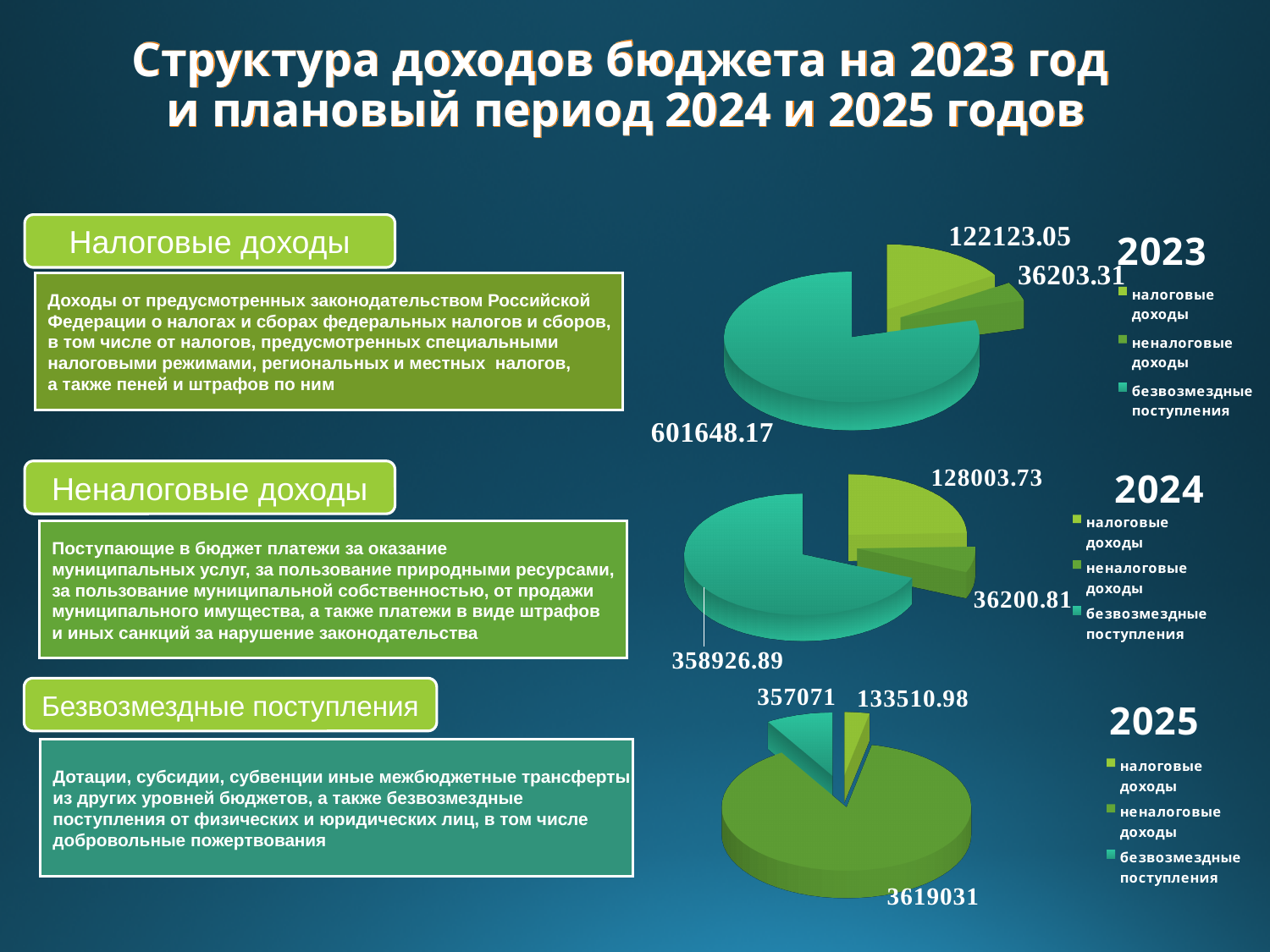
In the 2023 chart, what is the value for неналоговые доходы? 36203.31 In the 2023 chart, what is the value of the largest slice (безвозмездные поступления)? 601648.17 In the 2024 chart, what is the value for налоговые доходы? 128003.73 How many entries does the legend of the 2023 chart list? 3 In the 2024 chart, which slice is the smallest? неналоговые доходы (36200.81) In the 2023 chart, what is the value for налоговые доходы? 122123.05 Which is larger: the налоговые доходы value in the 2023 chart or in the 2024 chart? 2024 (128003.73) How many slices does the 2025 pie chart have? 3 What type of chart is used for the 2023 budget revenue structure? pie chart In the 2025 chart, what value is printed on the largest slice? 3619031 In the 2023 chart, what is the difference between the налоговые доходы value (122123.05) and the неналоговые доходы value (36203.31)? 85919.74 In the 2024 chart, what is the value of the largest slice (безвозмездные поступления)? 358926.89